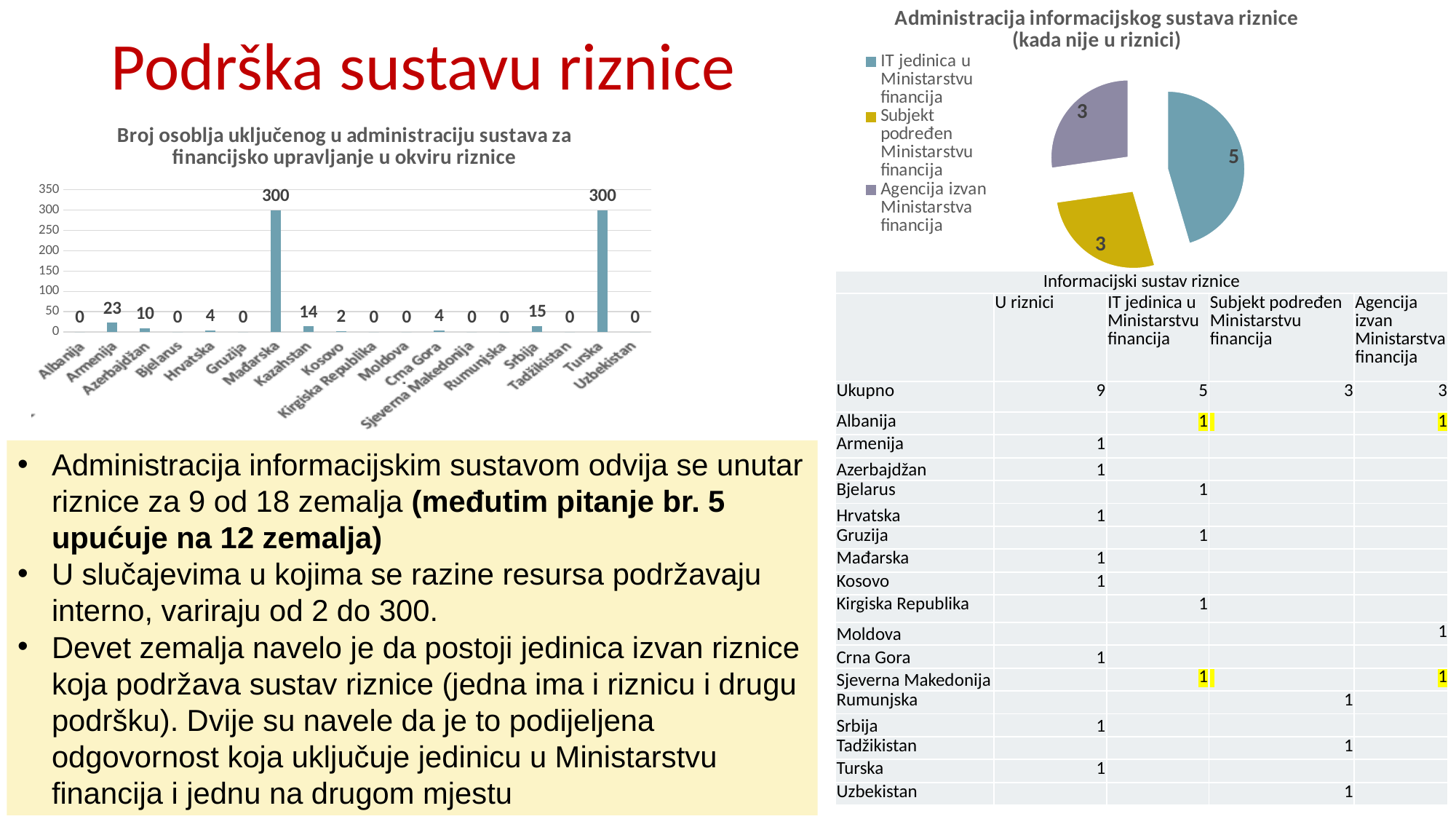
In the pie chart 'Administracija informacijskog sustava riznice (kada nije u riznici)', what colour is the slice for 'Agencija izvan Ministarstva financija'? Purple How many categories does the legend of the pie chart 'Administracija informacijskog sustava riznice (kada nije u riznici)' list? 3 In the bar chart 'Broj osoblja uključenog u administraciju sustava za financijsko upravljanje u okviru riznice', which countries have the highest value? Mađarska and Turska In the bar chart 'Broj osoblja uključenog u administraciju sustava za financijsko upravljanje u okviru riznice', which is larger, the value for Azerbajdžan or the value for Srbija? Srbija In the bar chart 'Broj osoblja uključenog u administraciju sustava za financijsko upravljanje u okviru riznice', how many countries are shown on the x axis? 18 In the bar chart 'Broj osoblja uključenog u administraciju sustava za financijsko upravljanje u okviru riznice', what is the value for Kosovo? 2 In the bar chart 'Broj osoblja uključenog u administraciju sustava za financijsko upravljanje u okviru riznice', what is the value for Srbija? 15 In the pie chart 'Administracija informacijskog sustava riznice (kada nije u riznici)', what is the value for 'IT jedinica u Ministarstvu financija'? 5 In the bar chart 'Broj osoblja uključenog u administraciju sustava za financijsko upravljanje u okviru riznice', what is the difference between the values for Armenija and Kazahstan? 9 In the pie chart 'Administracija informacijskog sustava riznice (kada nije u riznici)', which category has the largest slice? IT jedinica u Ministarstvu financija What kind of chart is 'Broj osoblja uključenog u administraciju sustava za financijsko upravljanje u okviru riznice'? Bar chart In the bar chart 'Broj osoblja uključenog u administraciju sustava za financijsko upravljanje u okviru riznice', what is the value for Armenija? 23